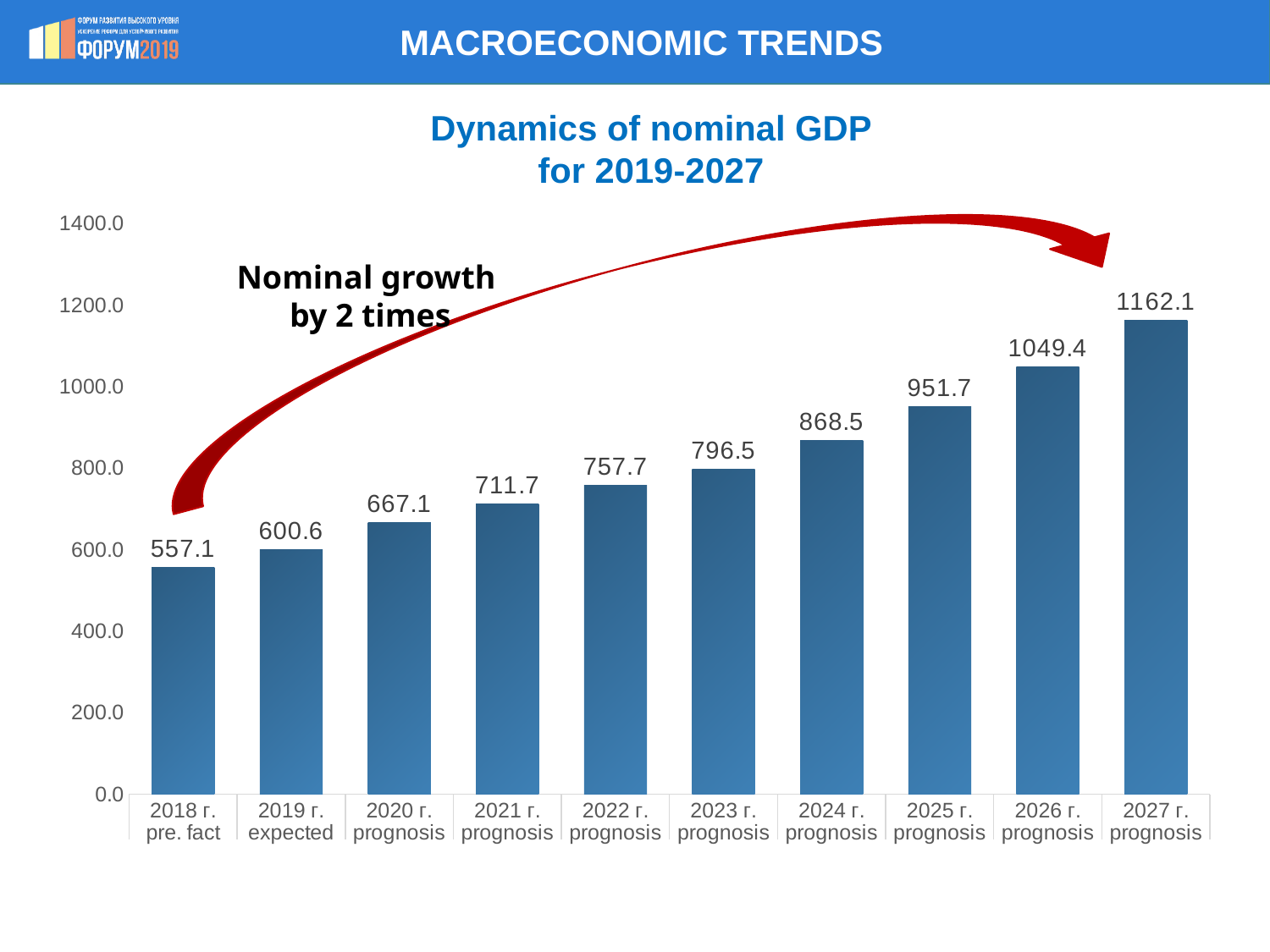
What kind of chart is shown on the slide? Bar chart What is the difference between the nominal GDP values for 2027 г. prognosis and 2018 г. pre. fact? 605.0 What is the difference between the nominal GDP values for 2020 г. prognosis and 2019 г. expected? 66.5 What is the nominal GDP value for 2027 г. prognosis? 1162.1 Which is larger, the nominal GDP value for 2024 г. prognosis or for 2025 г. prognosis? 2025 г. prognosis Do the nominal GDP values rise or fall from 2018 to 2027? Rise Is the value for 2026 г. prognosis greater or less than 1000.0? greater Which year has the highest nominal GDP value? 2027 г. prognosis What is the nominal GDP value for 2023 г. prognosis? 796.5 Which year has the lowest nominal GDP value? 2018 г. pre. fact How many years (bars) are shown in the chart? 10 What is the nominal GDP value for 2018 г. pre. fact? 557.1